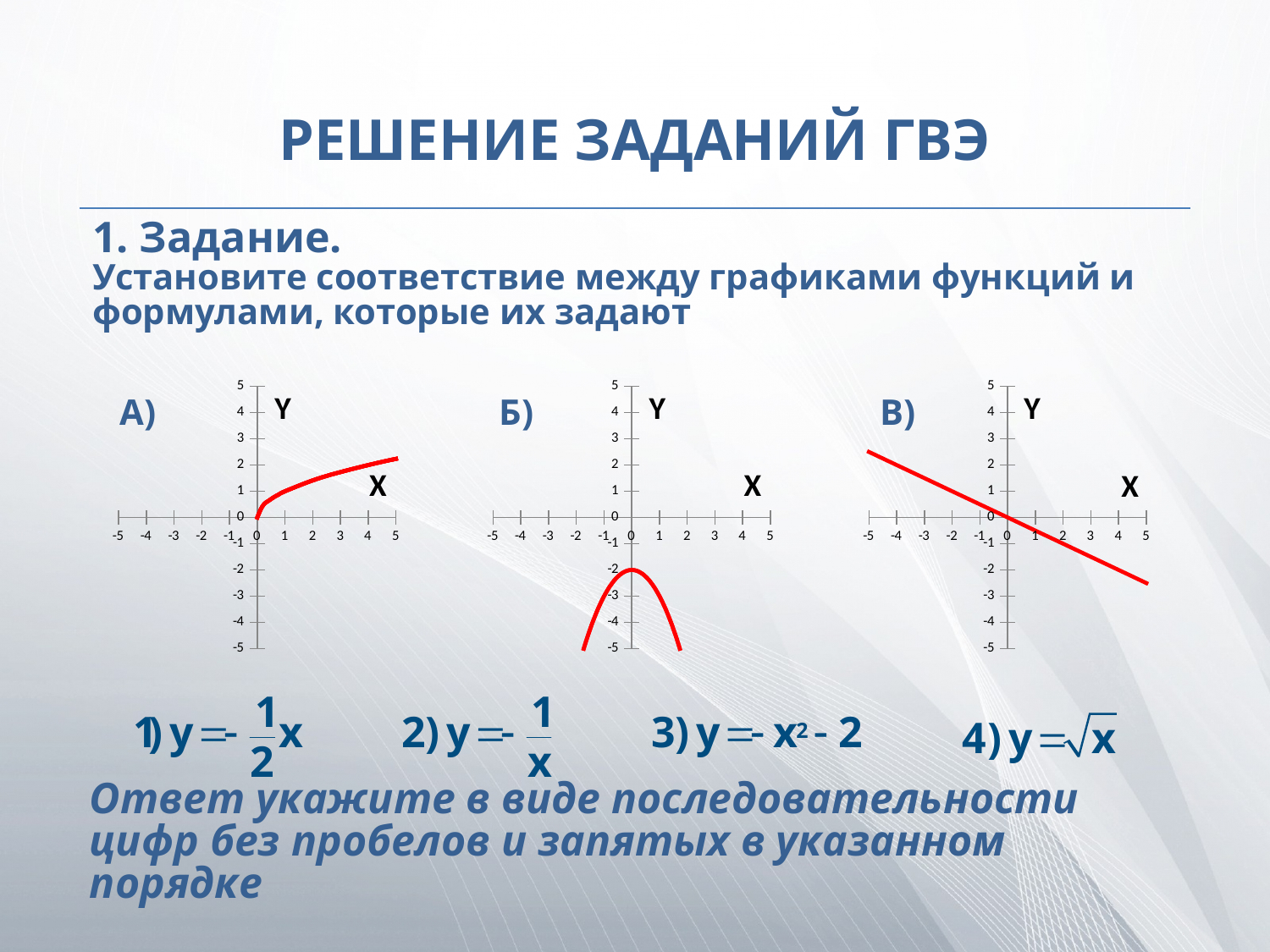
In graph В), does the line rise or fall as x increases? falls Which graph shows a curve that lies entirely below the x axis? Б) In graph А), what is the y value of the curve at x = 0? 0 What kind of chart is graph А)? line chart In graph В), is the value of the line at x = -4 greater or less than 1? greater How many graphs are shown on the slide? 3 In graph Б), what is the y value at the highest point of the curve? -2 In graph Б), is the highest point of the curve greater or less than 0? less In graph А), does the curve rise or fall as x increases? rises What colour are the plotted curves in the three graphs? red In graph А), is the value of the curve at x = 4 greater or less than 1? greater In graph В), what is the y value of the line at x = 0? 0